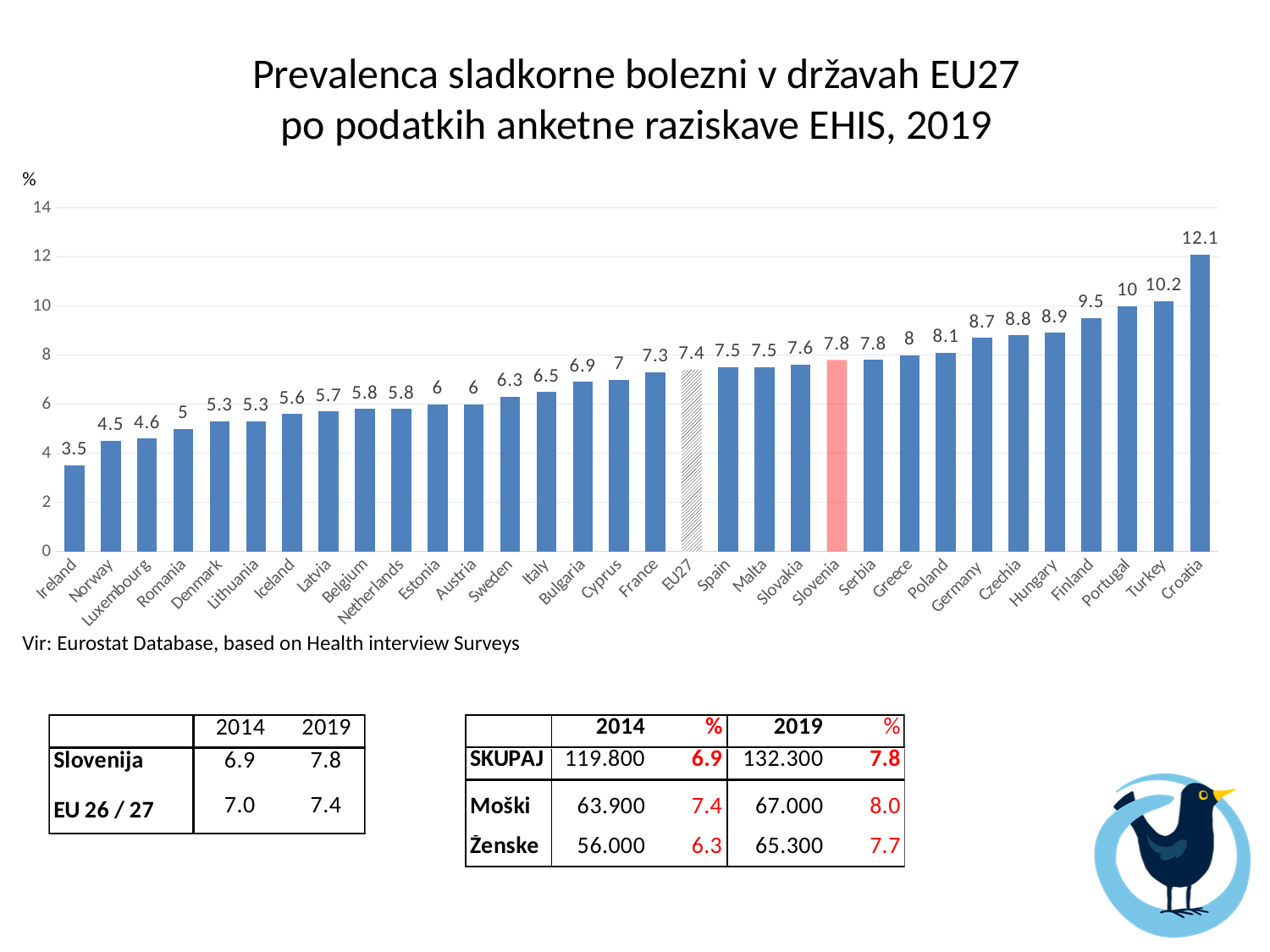
What kind of chart is this? Bar chart Do the values rise or fall from left to right along the x axis? Rise What is the difference between the values for Croatia and Ireland? 8.6 Which is larger, the value for Finland or the value for Germany? Finland What is the value for EU27? 7.4 Which country has the highest value? Croatia What is the value for Croatia? 12.1 What is the difference between the values for Slovenia and EU27? 0.4 What is the value for Germany? 8.7 How many bars are shown in the chart? 32 What is the value for Slovenia? 7.8 Which country has the lowest value? Ireland